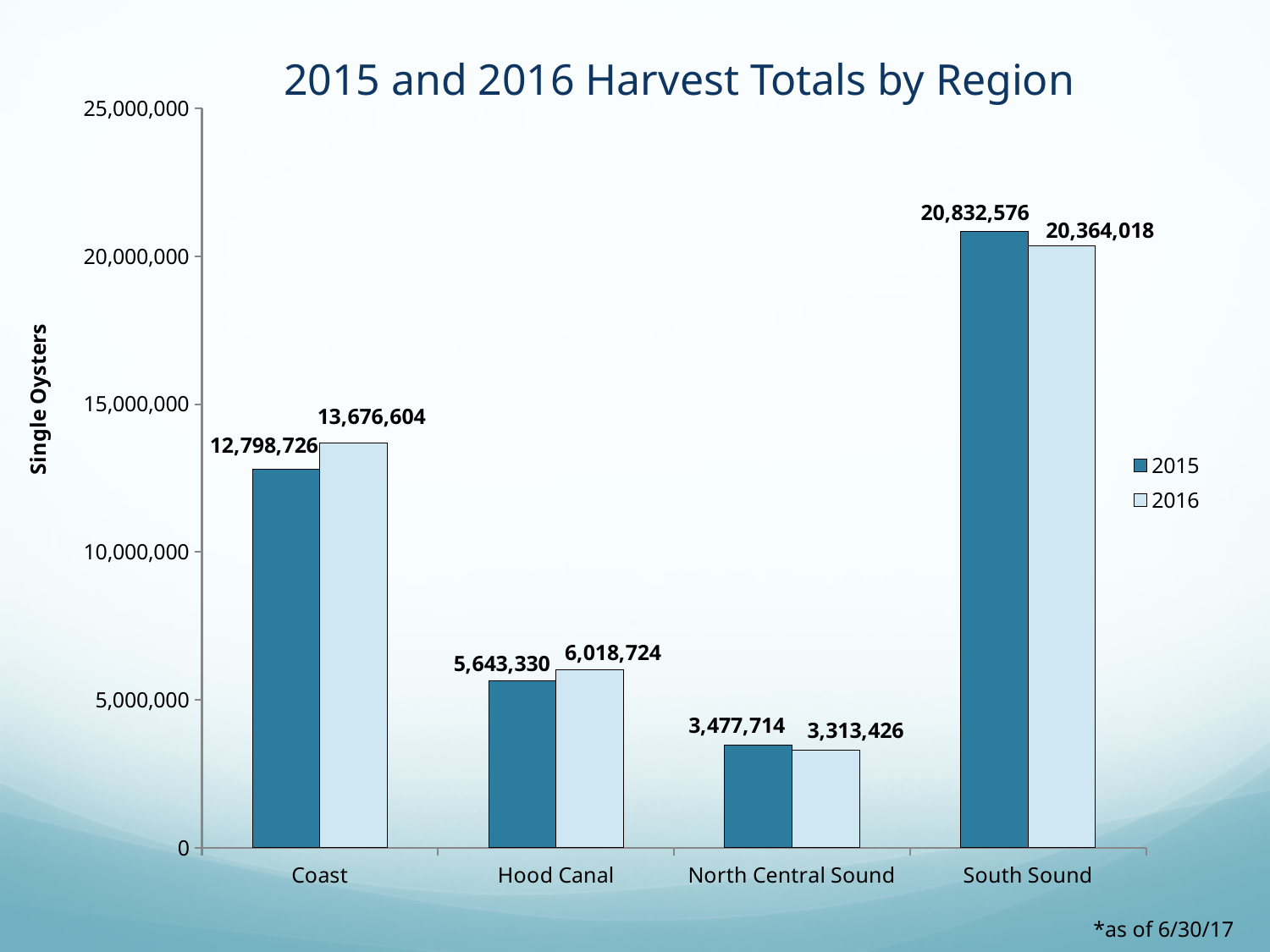
How many regions are shown on the x axis? 4 What kind of chart is shown on the slide? Bar chart What was the 2015 harvest total for the Coast region? 12,798,726 What was the 2016 harvest total for South Sound? 20,364,018 How many series does the legend list? 2 What is the difference between the 2015 and 2016 harvest totals for South Sound? 468,558 For North Central Sound, which year had the larger harvest total, 2015 or 2016? 2015 Is the 2015 harvest total for Hood Canal greater or less than 5,000,000? greater Which region had the highest 2015 harvest total? South Sound Which region had the lowest 2016 harvest total? North Central Sound What is the difference between the 2016 and 2015 harvest totals for the Coast region? 877,878 What was the 2016 harvest total for Hood Canal? 6,018,724